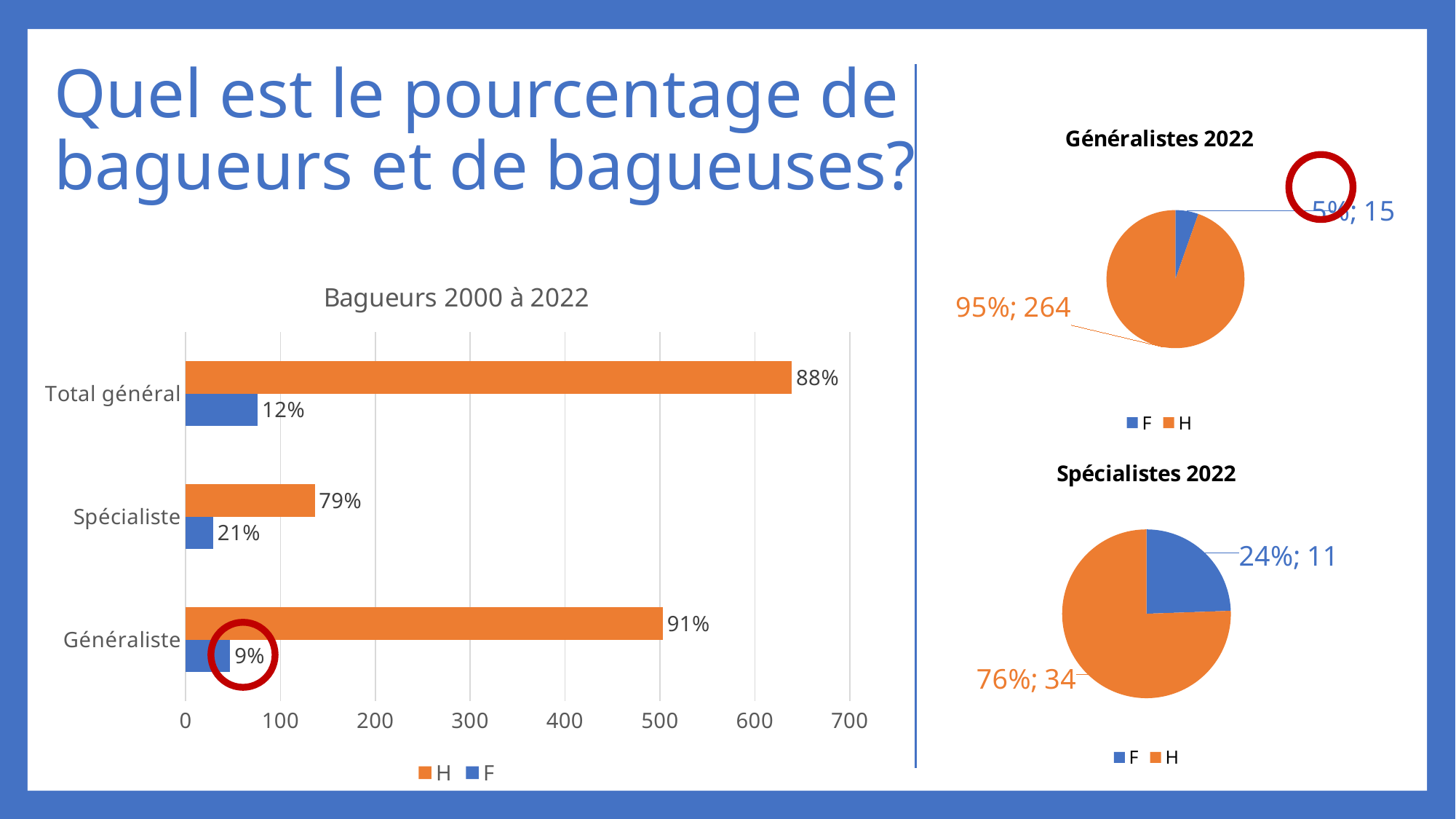
In the chart 'Bagueurs 2000 à 2022', how many categories are shown on the vertical axis? 3 In the chart 'Bagueurs 2000 à 2022', what data label is shown on the H bar for Total général? 88% How many series does the legend of the pie chart 'Spécialistes 2022' list? 2 In the pie chart 'Généralistes 2022', what share of the pie is F? 5% In the chart 'Bagueurs 2000 à 2022', which category has the longest H bar? Total général In the pie chart 'Généralistes 2022', what is the count shown for H? 264 In the chart 'Bagueurs 2000 à 2022', is the H bar for Total général greater or less than 600 on the axis? greater In the chart 'Bagueurs 2000 à 2022', is the F bar for Généraliste greater or less than 100 on the axis? less In the chart 'Bagueurs 2000 à 2022', what data label is shown on the F bar for Généraliste? 9% In the pie chart 'Spécialistes 2022', what is the difference between the counts for H and F? 23 In the chart 'Bagueurs 2000 à 2022', what data label is shown on the F bar for Spécialiste? 21% What kind of chart is 'Bagueurs 2000 à 2022'? bar chart